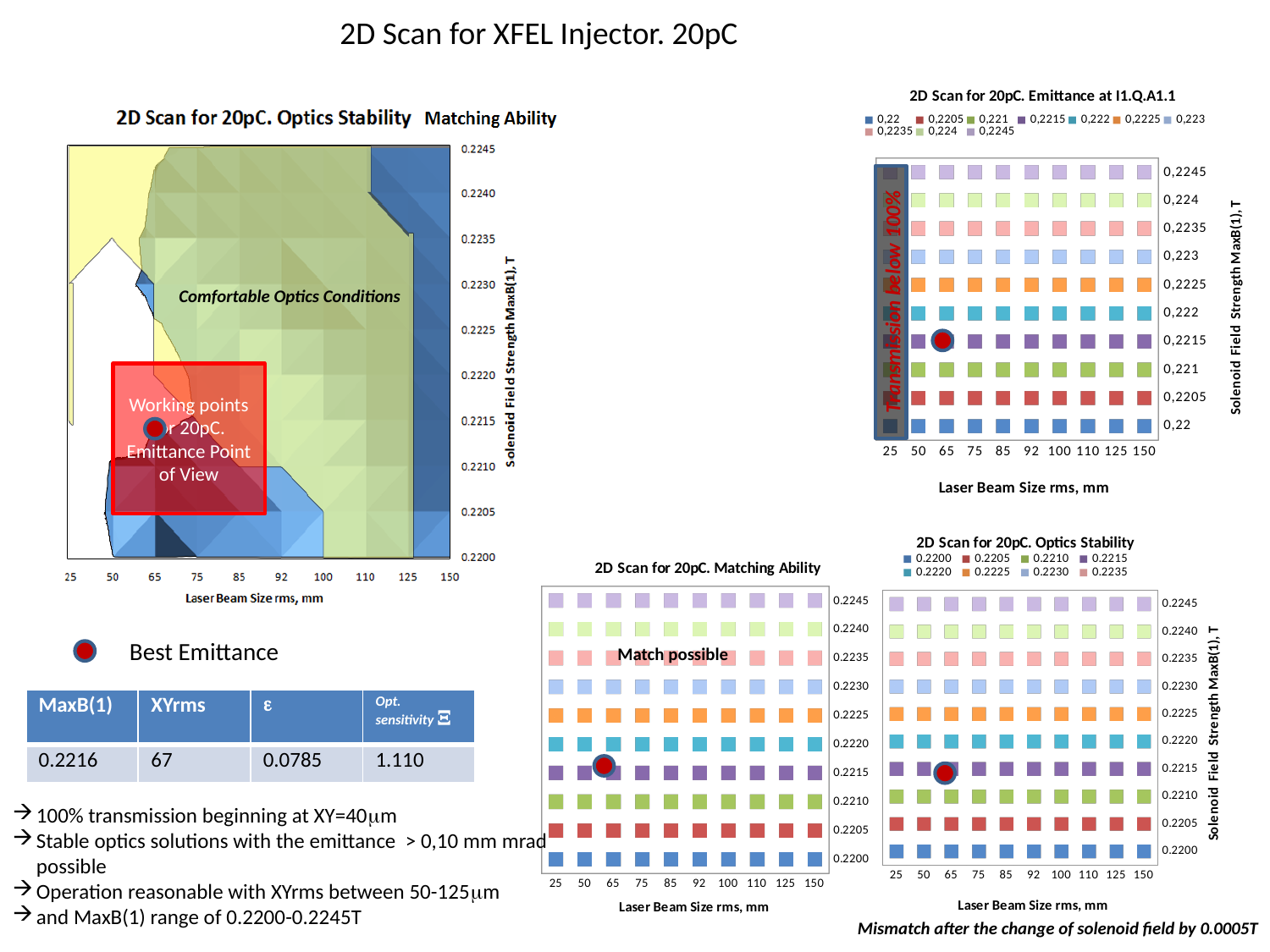
In the chart titled '2D Scan for 20pC. Matching Ability', how many laser beam size values are shown on the x axis? 10 In the chart titled '2D Scan for 20pC. Emittance at I1.Q.A1.1', what is the largest laser beam size value on the x axis? 150 What is the title of the chart in the top right of the slide? 2D Scan for 20pC. Emittance at I1.Q.A1.1 In the chart titled '2D Scan for 20pC. Emittance at I1.Q.A1.1', at which laser beam size is the column marked 'Transmission below 100%'? 25 In the chart titled '2D Scan for 20pC. Emittance at I1.Q.A1.1', what is the smallest laser beam size value on the x axis? 25 In the chart titled '2D Scan for 20pC. Optics Stability' at the bottom right, how many series does the legend list? 8 In the chart titled '2D Scan for 20pC. Optics Stability' at the bottom right, what is the highest solenoid field strength value labelled on the right-hand axis? 0.2245 In the chart titled '2D Scan for 20pC. Emittance at I1.Q.A1.1', what is the lowest solenoid field strength value labelled on the right-hand axis? 0,22 What kind of chart is the '2D Scan for 20pC. Emittance at I1.Q.A1.1' chart? scatter chart What is the x-axis label of the chart titled '2D Scan for 20pC. Matching Ability'? Laser Beam Size rms, mm In the chart titled '2D Scan for 20pC. Matching Ability', how many solenoid field strength values are labelled on the right-hand axis? 10 In the chart titled '2D Scan for 20pC. Emittance at I1.Q.A1.1', how many series does the legend list? 10